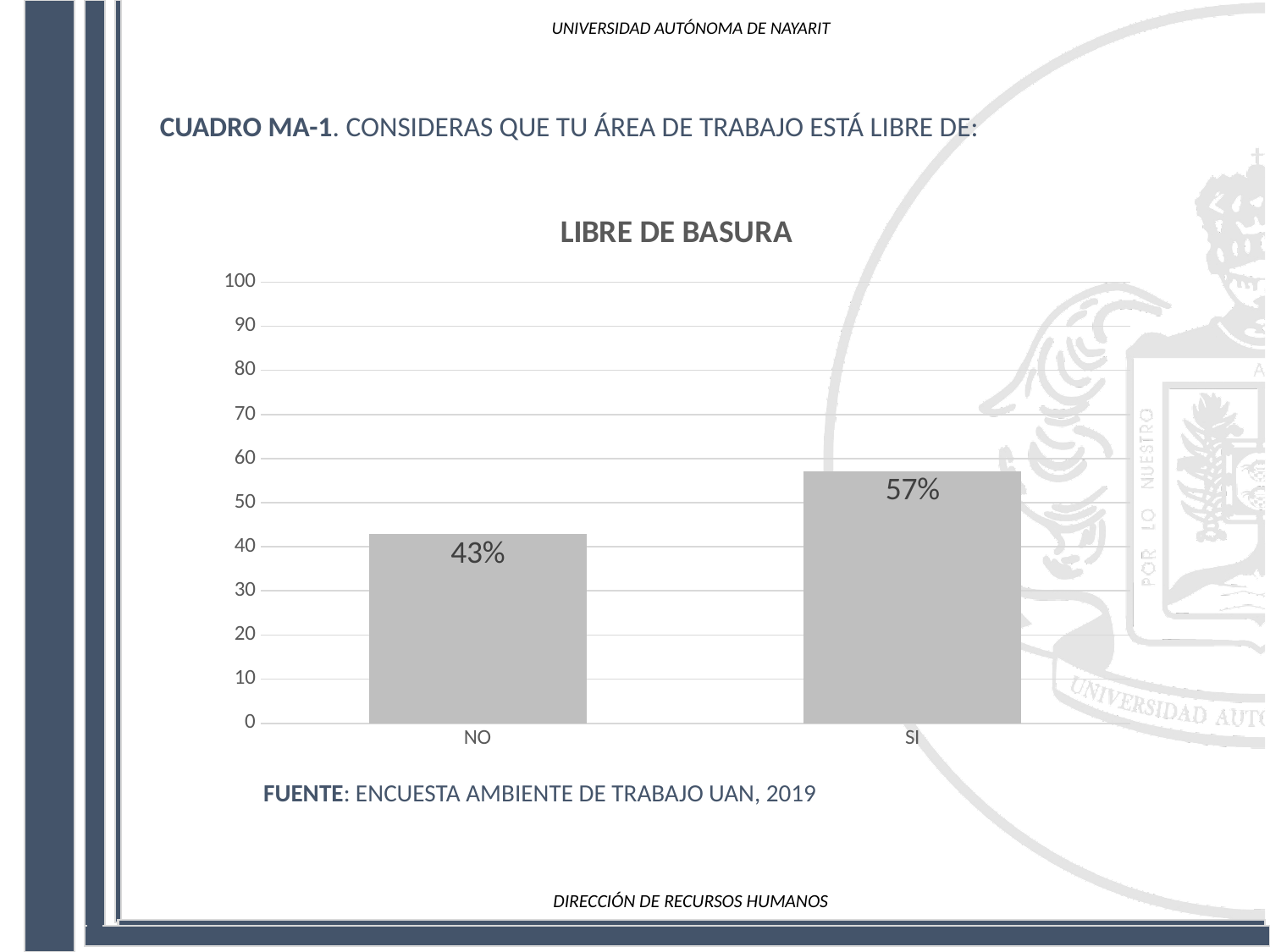
What is the value for SI in the LIBRE DE BASURA chart? 57% Which category has the highest value in the chart? SI What is the difference between the values for SI and NO? 14% What is the highest value shown on the y axis of the chart? 100 Which is larger, the value for NO or the value for SI? SI What is the title of the chart? LIBRE DE BASURA What kind of chart is shown on the slide? bar chart How many categories are shown on the x axis of the chart? 2 Is the value for SI greater or less than 50? greater What is the value for NO in the LIBRE DE BASURA chart? 43% Which category has the lowest value in the chart? NO Is the value for NO greater or less than 50? less